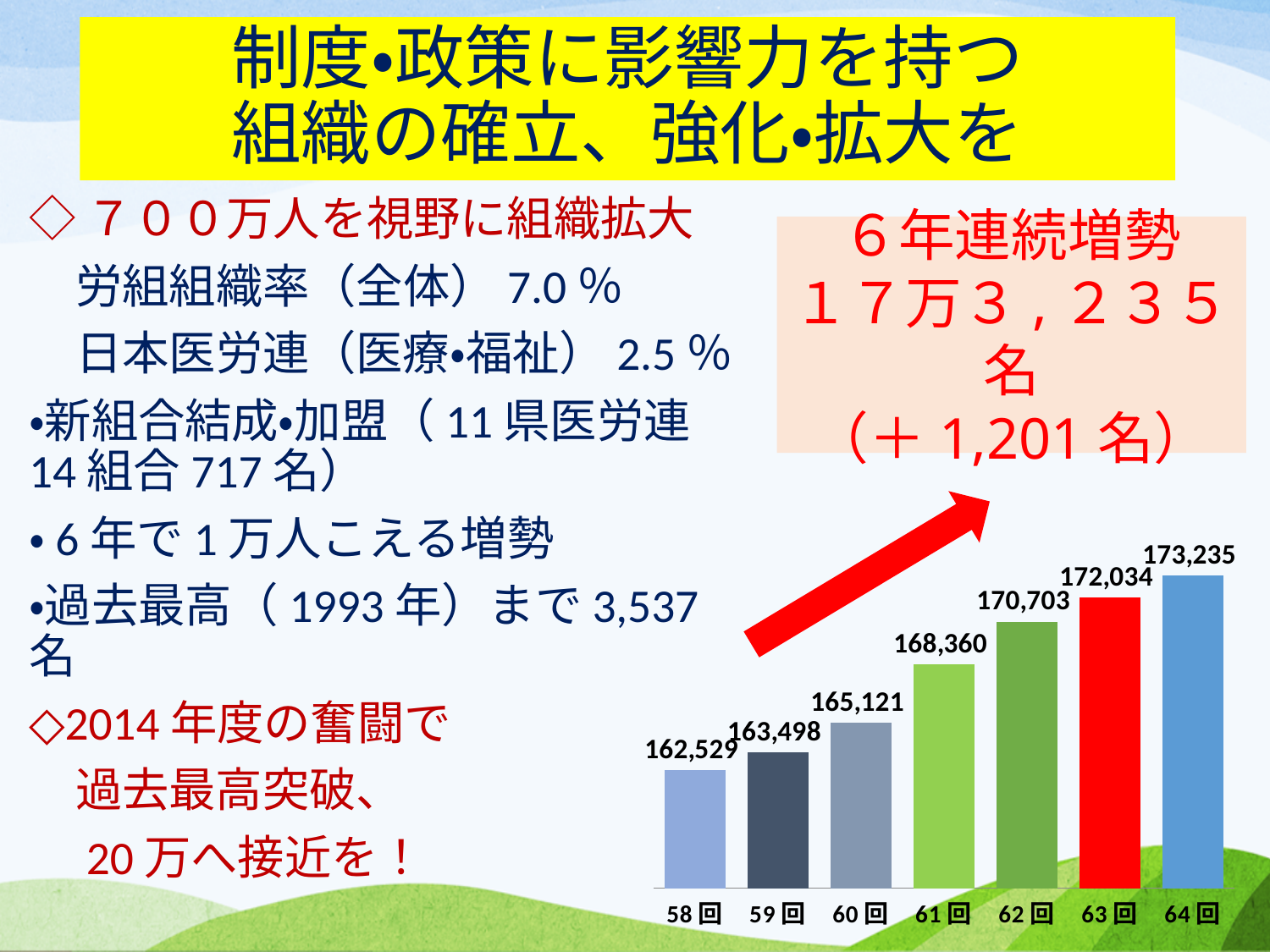
What colour is the bar for 63回 in the bar chart? red Which category has the lowest value in the bar chart? 58回 What value is shown for 61回 in the bar chart? 168,360 What kind of chart is shown on the slide? bar chart What is the difference between the values for 62回 and 61回 in the bar chart? 2,343 How many categories are shown in the bar chart? 7 Do the values in the bar chart rise or fall from 58回 to 64回? rise What value is shown for 63回 in the bar chart? 172,034 What value is shown for 58回 in the bar chart? 162,529 Which is larger in the bar chart, the value for 60回 or the value for 59回? 60回 What is the difference between the values for 64回 and 63回 in the bar chart? 1,201 Which category has the highest value in the bar chart? 64回